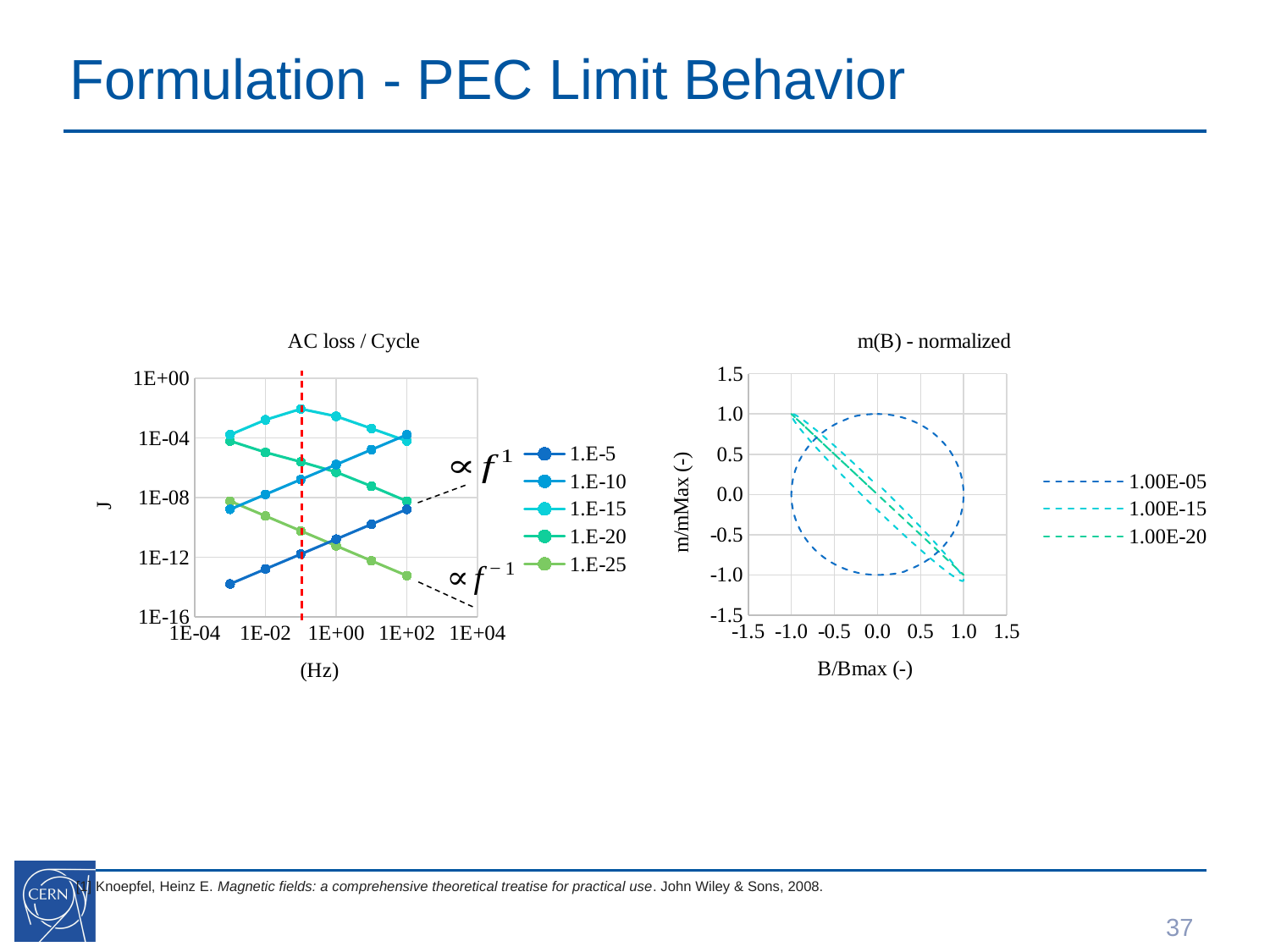
In the 'AC loss / Cycle' chart, does the 1.E-25 series rise or fall as frequency increases? fall In the 'AC loss / Cycle' chart, which series has the highest value at 1E-01 Hz? 1.E-15 In the 'AC loss / Cycle' chart, is the value of the 1.E-25 series at 1E+02 Hz greater or less than 1E-12? less What is the x-axis label of the 'AC loss / Cycle' chart? (Hz) What type of chart is the 'AC loss / Cycle' chart? line chart What is the y-axis label of the 'm(B) - normalized' chart? m/mMax (-) How many series does the legend of the 'AC loss / Cycle' chart list? 5 How many series does the legend of the 'm(B) - normalized' chart list? 3 In the 'AC loss / Cycle' chart, is the value of the 1.E-15 series at 1E-01 Hz greater or less than 1E-04? greater In the 'AC loss / Cycle' chart, does the 1.E-5 series rise or fall as frequency increases? rise In the 'AC loss / Cycle' chart, at 1E+02 Hz, which is larger: the 1.E-5 series or the 1.E-25 series? 1.E-5